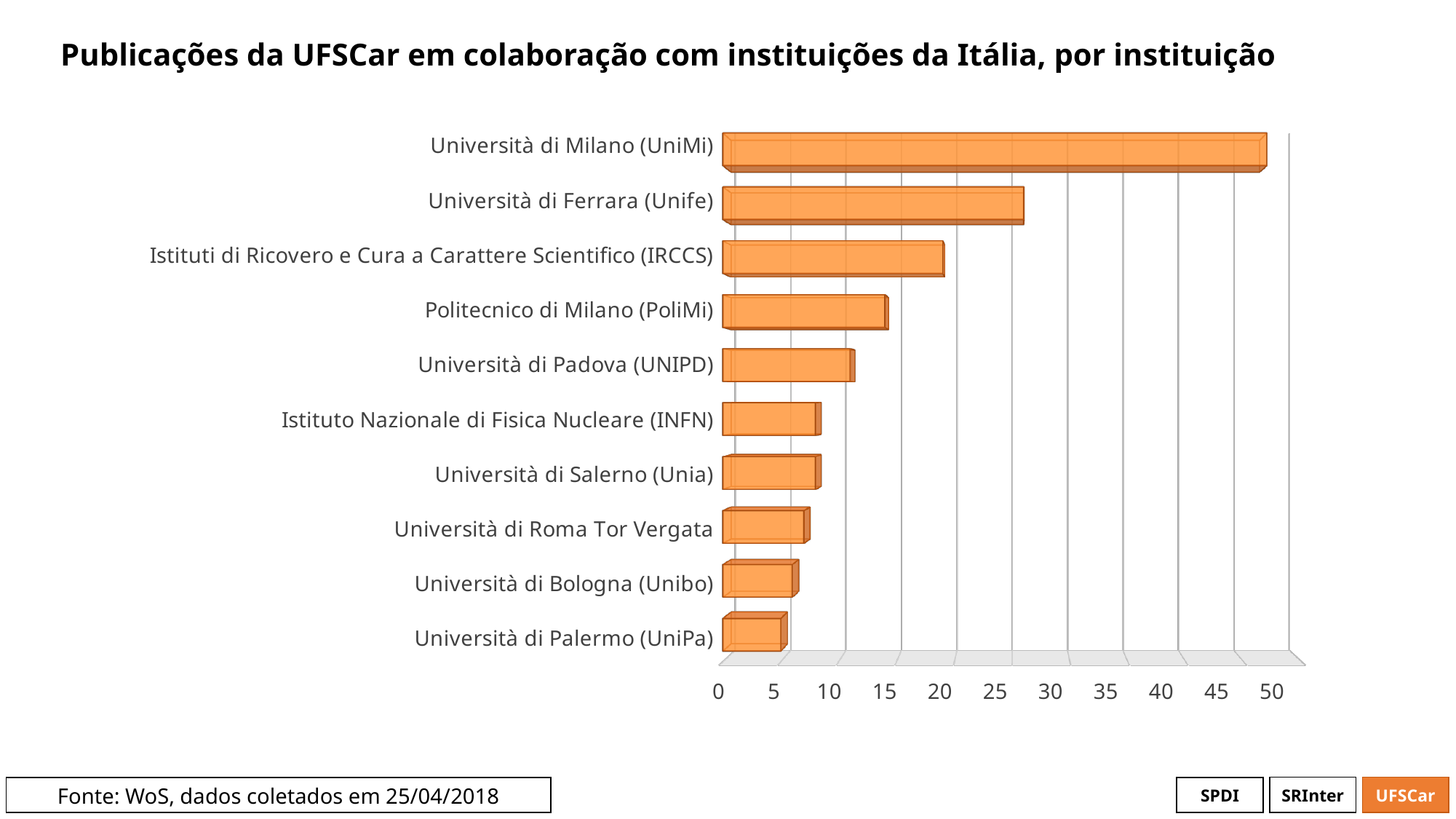
Is the value for Politecnico di Milano (PoliMi) greater or less than 20? less Is the value for Università di Milano (UniMi) greater or less than 45? greater Is the value for Università di Bologna (Unibo) greater or less than 10? less What kind of chart is shown on the slide? bar chart Which has more publications: Politecnico di Milano (PoliMi) or Università di Palermo (UniPa)? Politecnico di Milano (PoliMi) Which has more publications: Università di Milano (UniMi) or Università di Ferrara (Unife)? Università di Milano (UniMi) Which institution has the lowest number of publications in collaboration with UFSCar? Università di Palermo (UniPa) Which institution has the highest number of publications in collaboration with UFSCar? Università di Milano (UniMi) What is the title of the chart? Publicações da UFSCar em colaboração com instituições da Itália, por instituição How many institutions are listed in the chart? 10